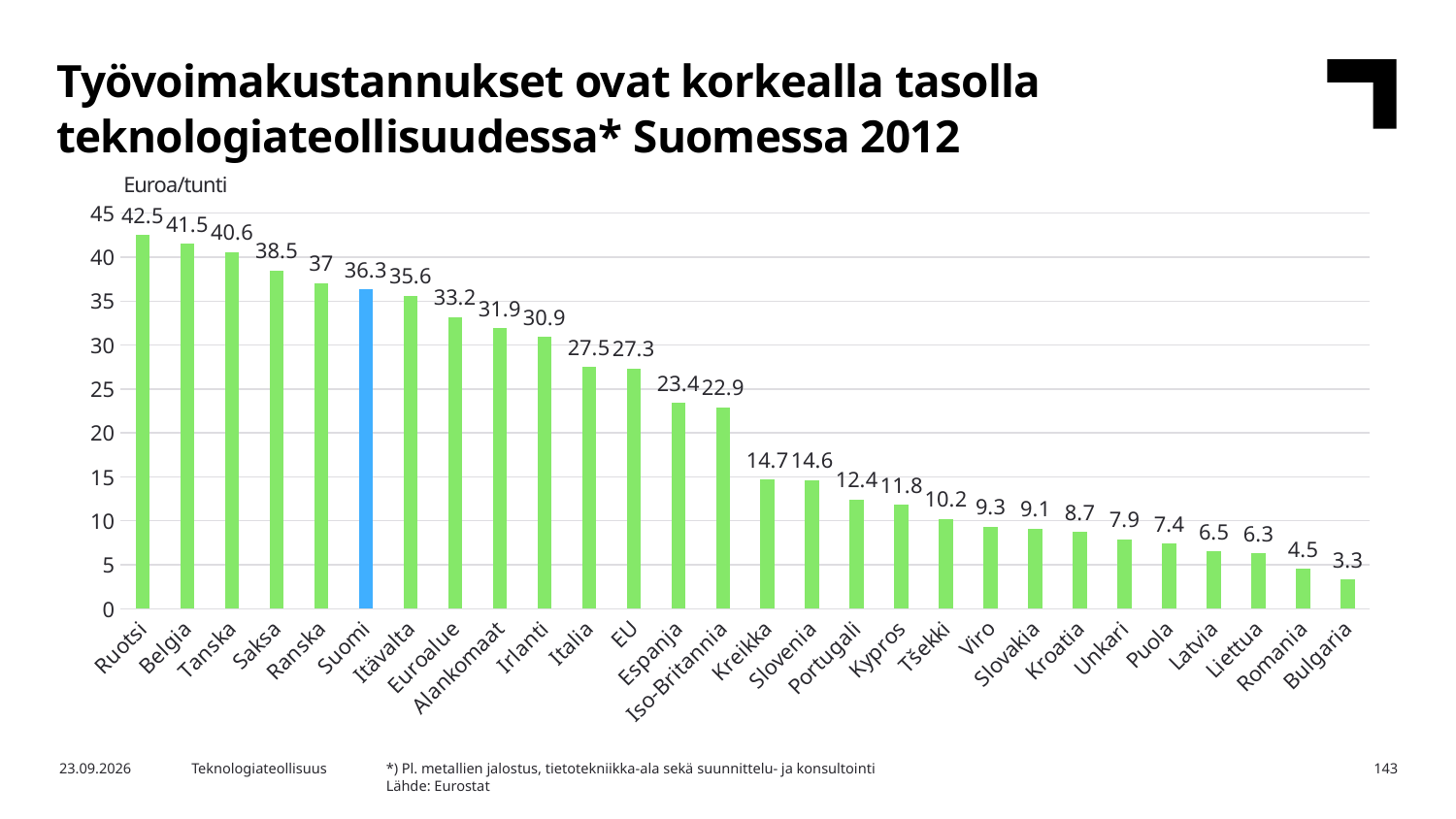
What is the value for Suomi? 36.3 Which is larger, the value for Saksa or the value for Itävalta? Saksa Do the values rise or fall from left to right along the x axis? fall What is the difference between the values for Ruotsi and Suomi? 6.2 Which country has the highest value? Ruotsi What is the value for Alankomaat? 31.9 What kind of chart is this? bar chart Which bar is coloured blue instead of green? Suomi How many countries or regions are shown on the x axis? 28 What is the value for Kypros? 11.8 What is the difference between the values for EU and Euroalue? 5.9 Which country has the lowest value? Bulgaria